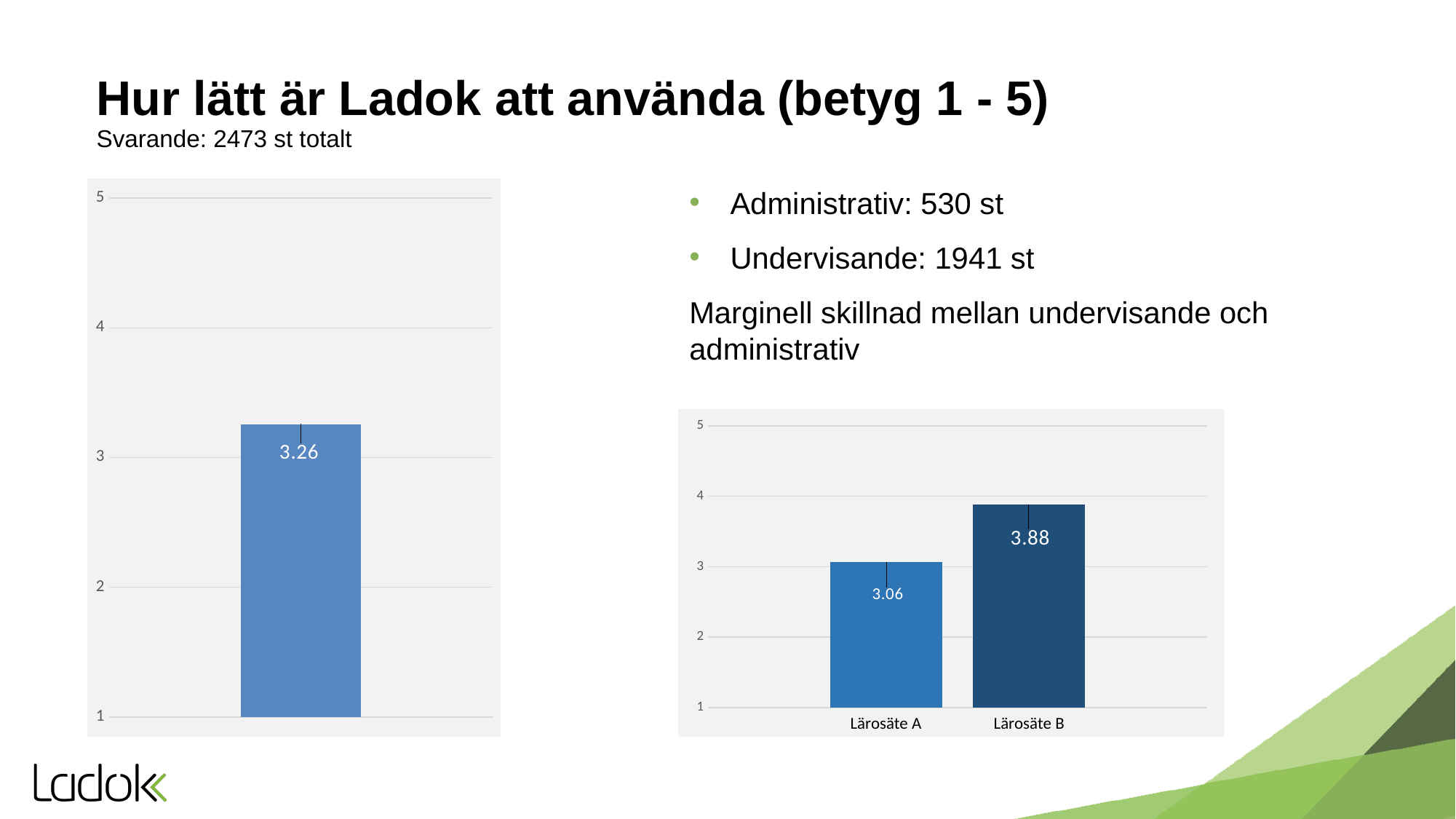
In the chart on the right of the slide, is the value for Lärosäte A or Lärosäte B larger? Lärosäte B In the chart on the left of the slide, is the value of the bar greater or less than 3? greater What kind of chart is shown on the right of the slide? bar chart In the chart on the right of the slide, how many categories are shown on the x axis? 2 In the chart on the left of the slide, what value is printed on the single bar? 3.26 In the chart on the right of the slide, what is the difference between the values for Lärosäte B and Lärosäte A? 0.82 In the chart on the right of the slide, is the value for Lärosäte B greater or less than 4? less In the chart on the right of the slide, which category has the highest value? Lärosäte B In the chart on the right of the slide, what is the value for Lärosäte B? 3.88 In the chart on the right of the slide, what is the value for Lärosäte A? 3.06 In the chart on the right of the slide, which category has the lowest value? Lärosäte A In the chart on the left of the slide, how many bars are plotted? 1